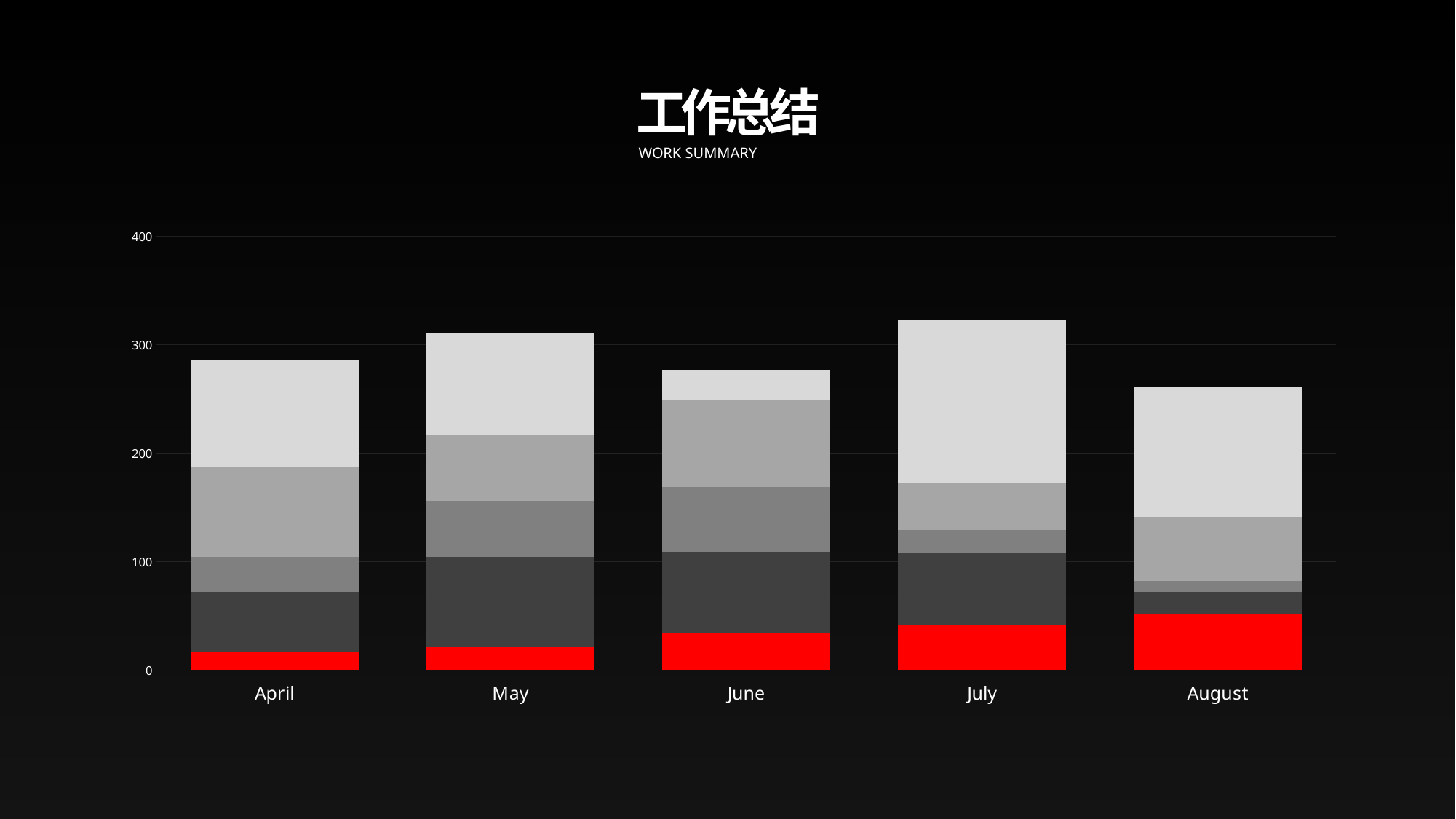
Is the total for July greater or less than 300? greater Is the total for August greater or less than 300? less What colour is the bottom segment of each stacked bar? red Which stacked bar is taller, May or June? May Is the total for May greater or less than 300? greater Which stacked bar is taller, July or April? July Which month has the shortest stacked bar? August Which month has the tallest stacked bar? July How many months are shown on the x axis of the chart? 5 What kind of chart is shown on the slide? stacked bar chart What is the highest value shown on the y axis? 400